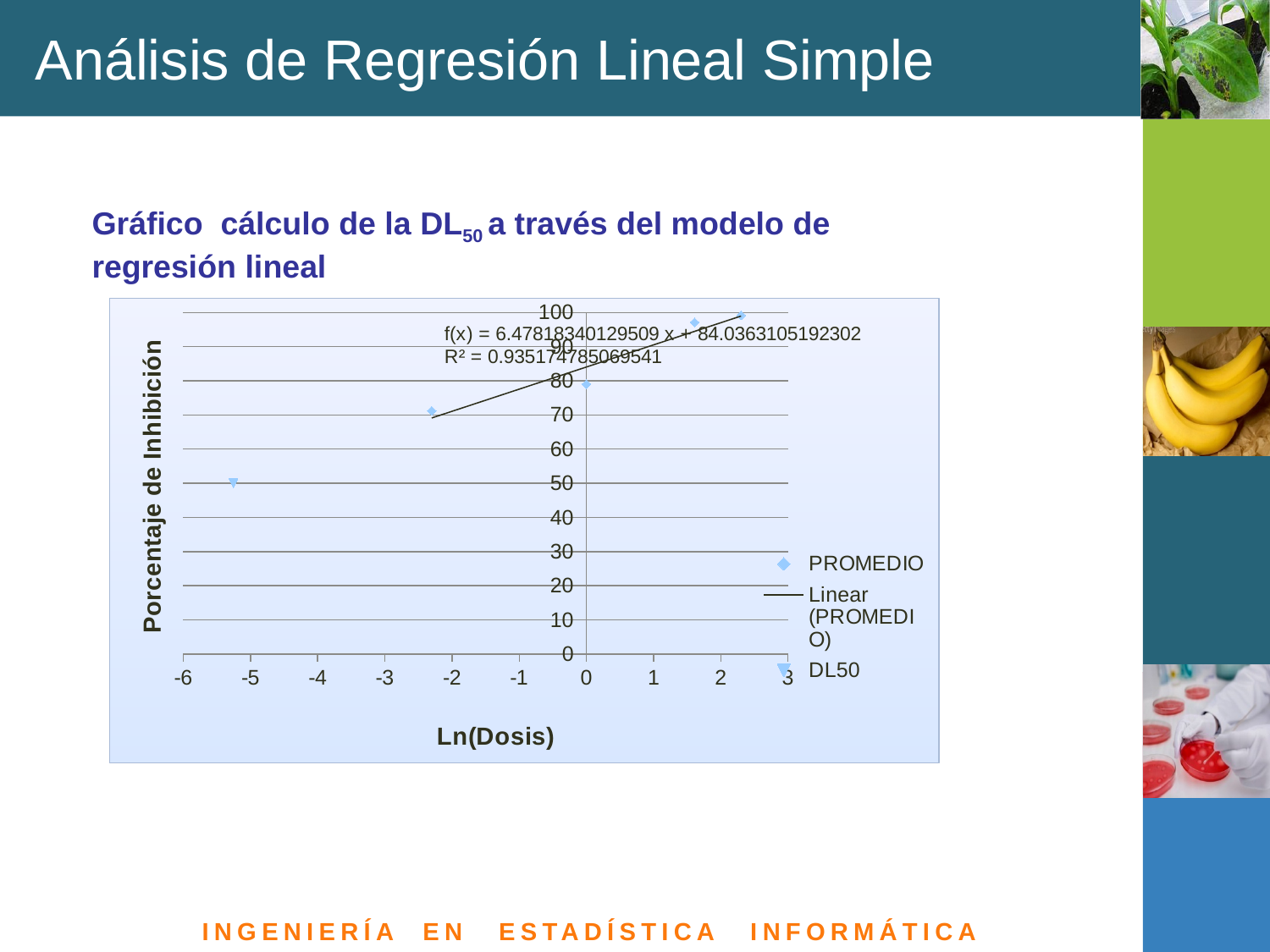
What is the title of the y axis of the chart? Porcentaje de Inhibición What is the title of the x axis of the chart? Ln(Dosis) Do the PROMEDIO values rise or fall as Ln(Dosis) increases? Rise What is the equation of the trendline shown on the chart? f(x) = 6.47818340129509 x + 84.0363105192302 How many series does the chart legend list? 3 Is the value of the DL50 point greater or less than 60? less Is the value of the PROMEDIO point near Ln(Dosis) = 2.3 greater or less than 90? greater How many PROMEDIO data points are plotted on the chart? 4 Which series is represented by the straight line in the chart? Linear (PROMEDIO) What kind of chart is shown on the slide? Scatter chart Is the value of the DL50 point greater or less than 40? greater What is the R² value shown on the chart? 0.935174785069541